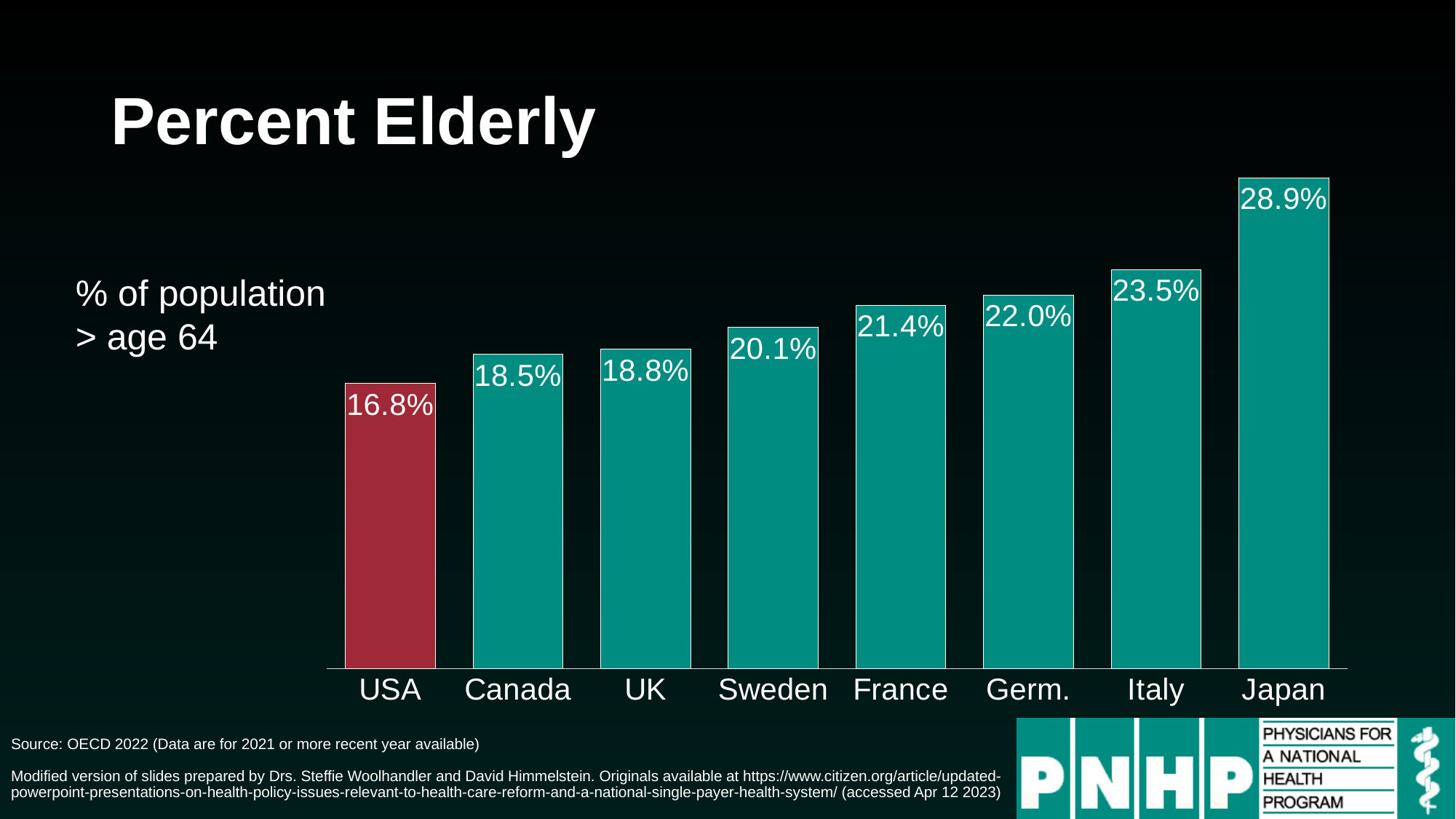
Which country has the lowest percent elderly? USA Which has a higher percent elderly, France or Canada? France Do the values rise or fall from left to right across the countries? Rise What is the percent elderly value for Sweden? 20.1% What is the difference in percent elderly between Italy and Germany? 1.5% Which country's bar is shown in a different colour (red) from the others? USA What is the percent elderly value for the USA? 16.8% How many countries are shown in the chart? 8 What type of chart is shown on the slide? Bar chart What is the difference in percent elderly between Japan and the USA? 12.1% Which country has the highest percent elderly? Japan What is the percent elderly value for Japan? 28.9%